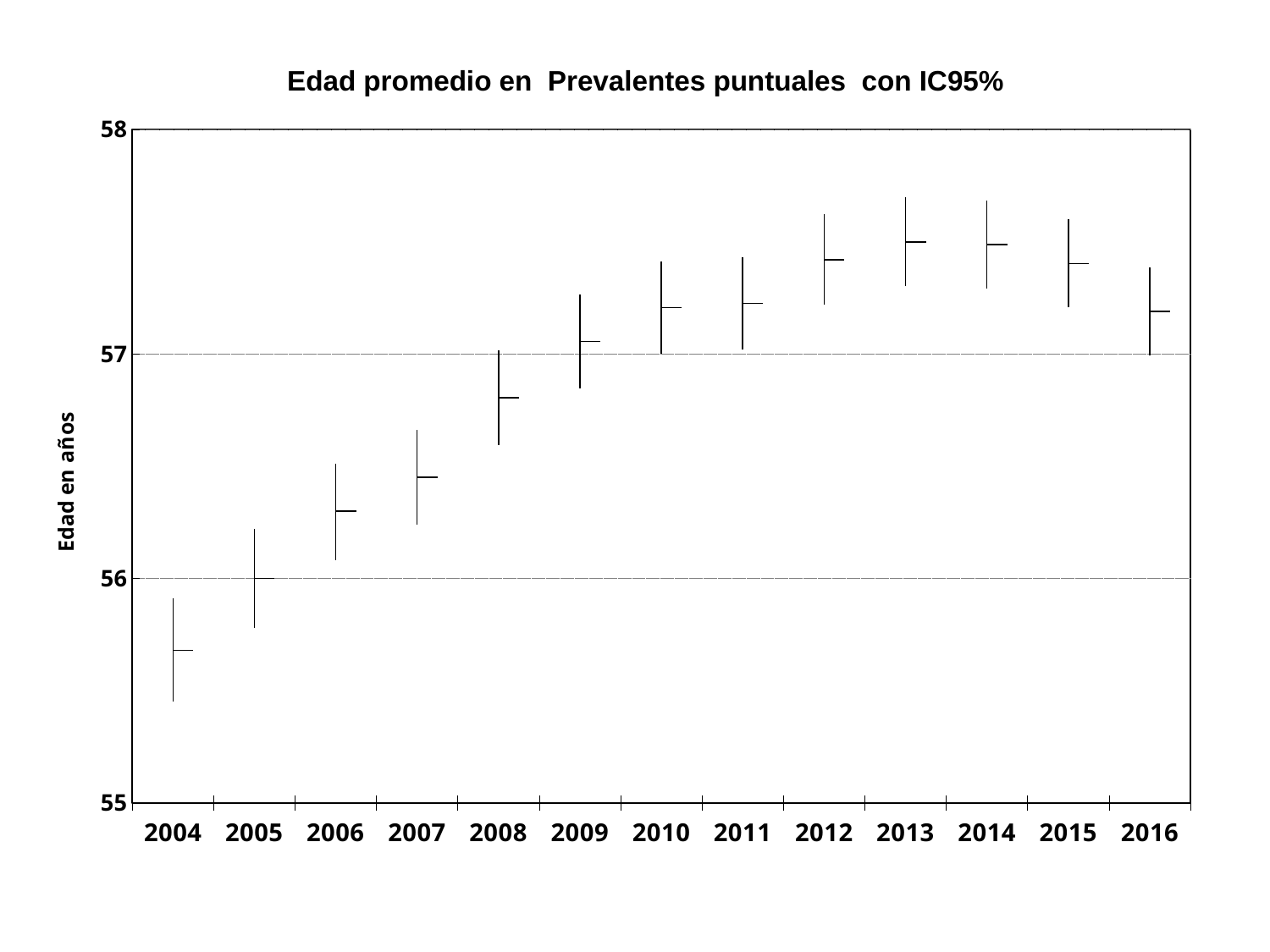
Which year has the lowest average age? 2004 Is the average age for 2013 greater or less than 58? less Which year has a higher average age, 2004 or 2013? 2013 What is the label of the vertical axis? Edad en años Is the average age for 2004 greater or less than 56? less Is the average age for 2006 greater or less than 57? less What is the title of the chart? Edad promedio en Prevalentes puntuales con IC95% Which year has a higher average age, 2006 or 2010? 2010 Does the average age generally rise or fall from 2004 to 2013? rise How many years are shown along the x axis? 13